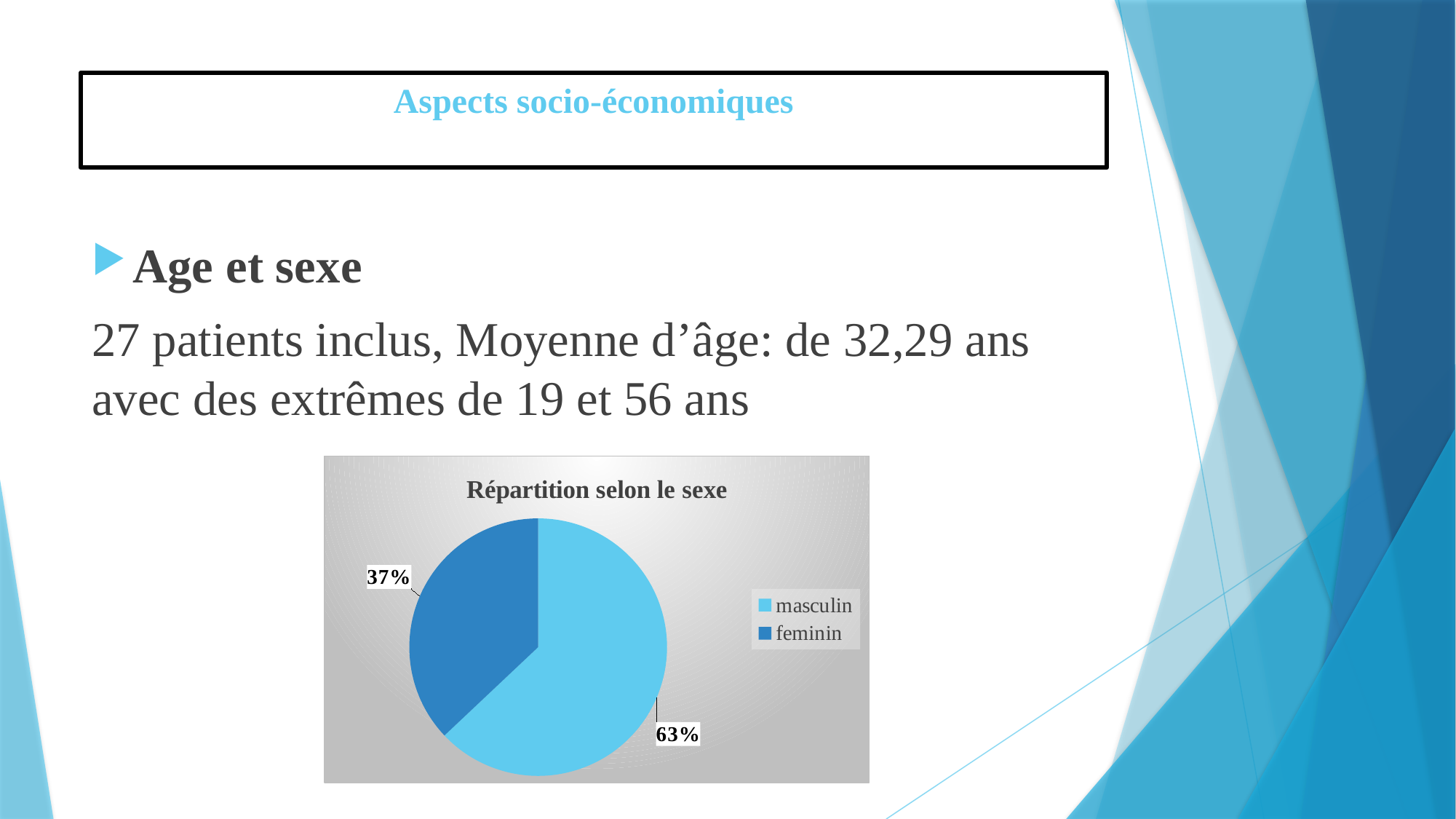
How many slices does the pie chart have? 2 Which category has the smallest share of the pie? feminin What percentage of the pie is labelled for masculin? 63% What percentage of the pie is labelled for feminin? 37% Which slice is larger, masculin or feminin? masculin Which category has the largest share of the pie? masculin What is the difference in percentage points between the masculin and feminin slices? 26 How many entries does the legend list? 2 Which legend entry is shown in the darker blue colour? feminin What is the title of the chart? Répartition selon le sexe What kind of chart is shown on the slide? pie chart